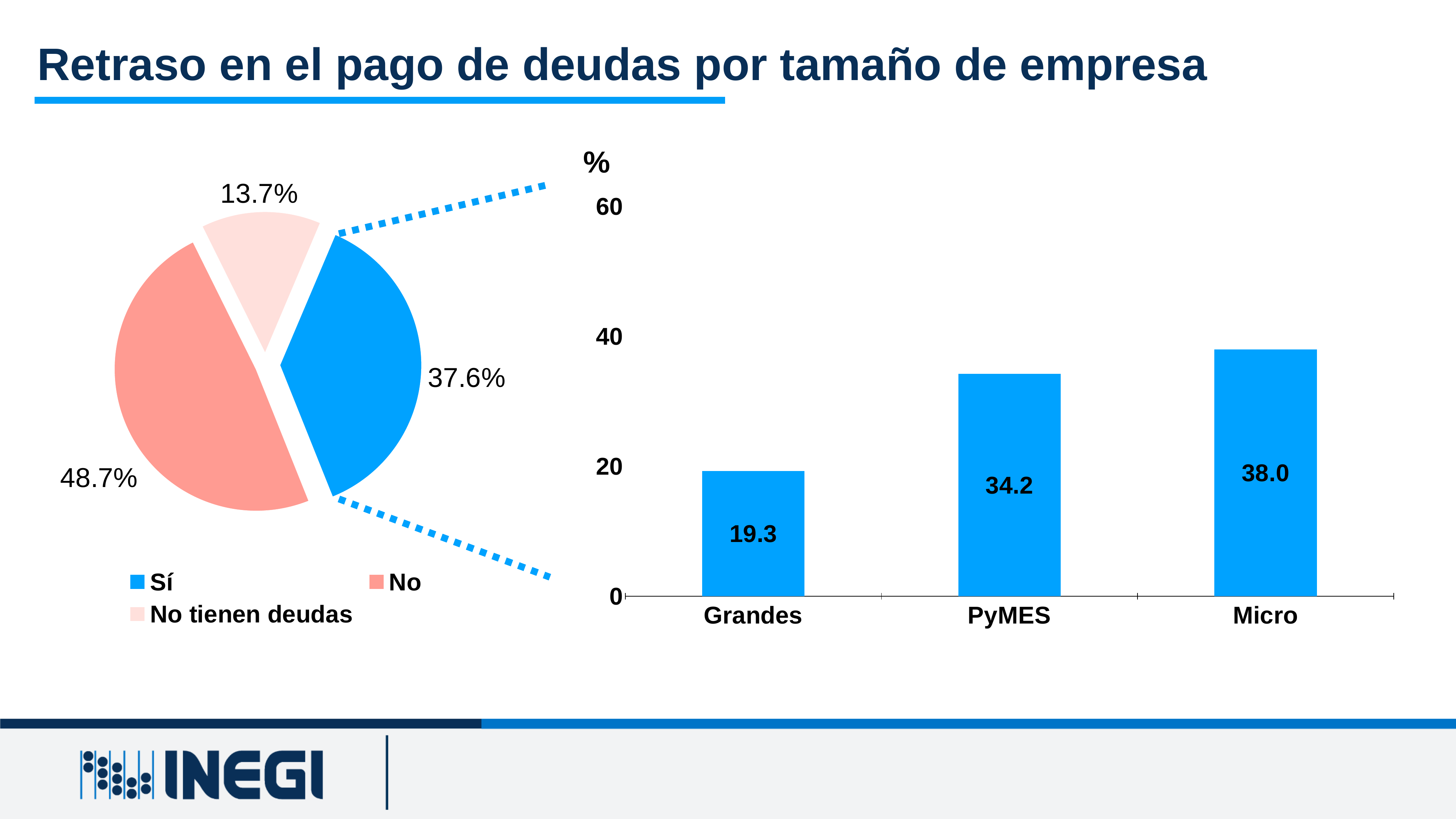
In the pie chart on the left, what is the value for the 'Sí' slice? 37.6% In the pie chart on the left, which slice is the smallest? No tienen deudas In the pie chart on the left, which slice is the largest? No In the bar chart on the right, what is the value for PyMES? 34.2 In the bar chart on the right, do the values rise or fall from Grandes to Micro? rise In the pie chart on the left, what is the value for the 'No' slice? 48.7% In the pie chart on the left, what is the difference between the 'No' and 'Sí' slices? 11.1% In the pie chart on the left, what is the value for the 'No tienen deudas' slice? 13.7% In the pie chart on the left, how many slices are there? 3 In the bar chart on the right, which category has the highest value? Micro In the bar chart on the right, what is the value for Grandes? 19.3 In the bar chart on the right, what is the difference between Micro and Grandes? 18.7